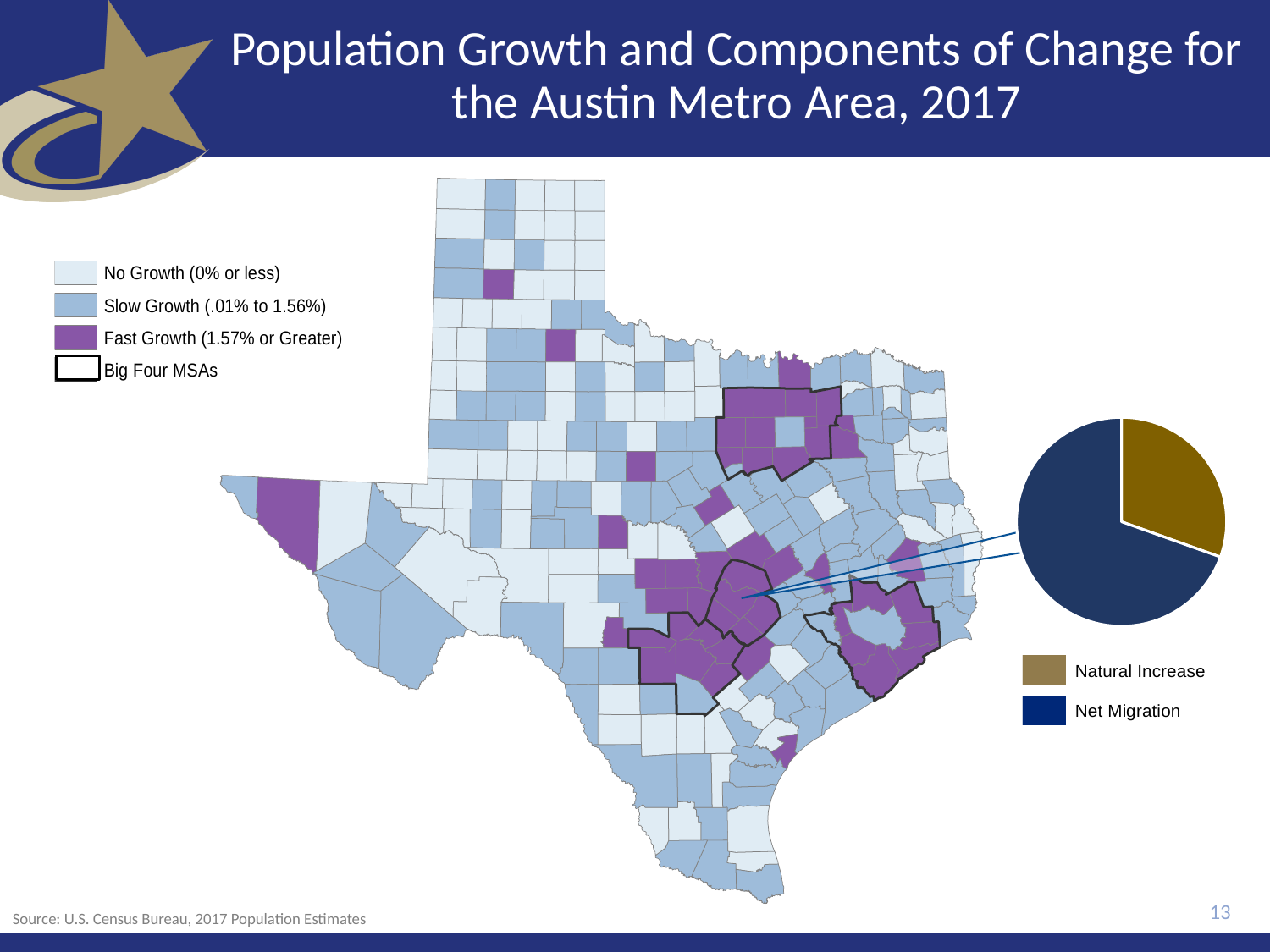
Is the Natural Increase share of the pie chart greater or less than 50%? less What kind of chart is shown on the right side of the slide? pie chart Is the Net Migration share of the pie chart greater or less than 50%? greater What are the two components of change listed in the pie chart legend? Natural Increase and Net Migration In the pie chart, which component is larger, Natural Increase or Net Migration? Net Migration Which slice of the pie chart is the largest? Net Migration What colour represents Net Migration in the pie chart? dark blue How many slices does the pie chart have? 2 Which slice of the pie chart is the smallest? Natural Increase How many entries does the pie chart's legend list? 2